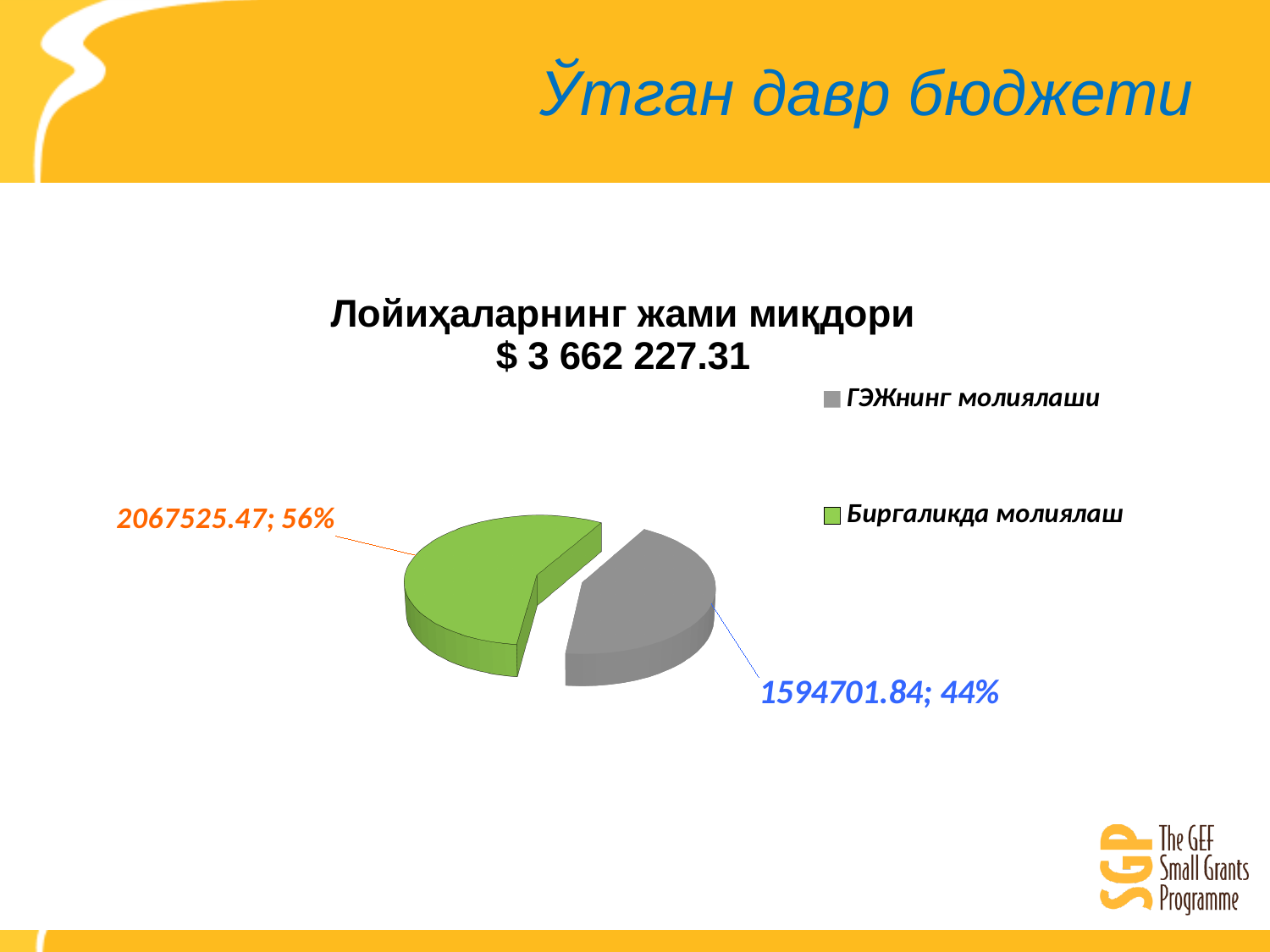
Which slice of the pie is the largest? Биргаликда молиялаш What kind of chart is shown on the slide? pie chart What is the value shown for ГЭЖнинг молиялаши? 1594701.84 Which is larger, Биргаликда молиялаш or ГЭЖнинг молиялаши? Биргаликда молиялаш How many slices does the pie chart have? 2 What total amount is stated in the chart title? $ 3 662 227.31 What is the difference in percentage points between the Биргаликда молиялаш and ГЭЖнинг молиялаши shares? 12 What share of the pie does Биргаликда молиялаш represent? 56% What is the value shown for Биргаликда молиялаш? 2067525.47 Which slice of the pie is the smallest? ГЭЖнинг молиялаши What colour is the Биргаликда молиялаш slice? green What share of the pie does ГЭЖнинг молиялаши represent? 44%